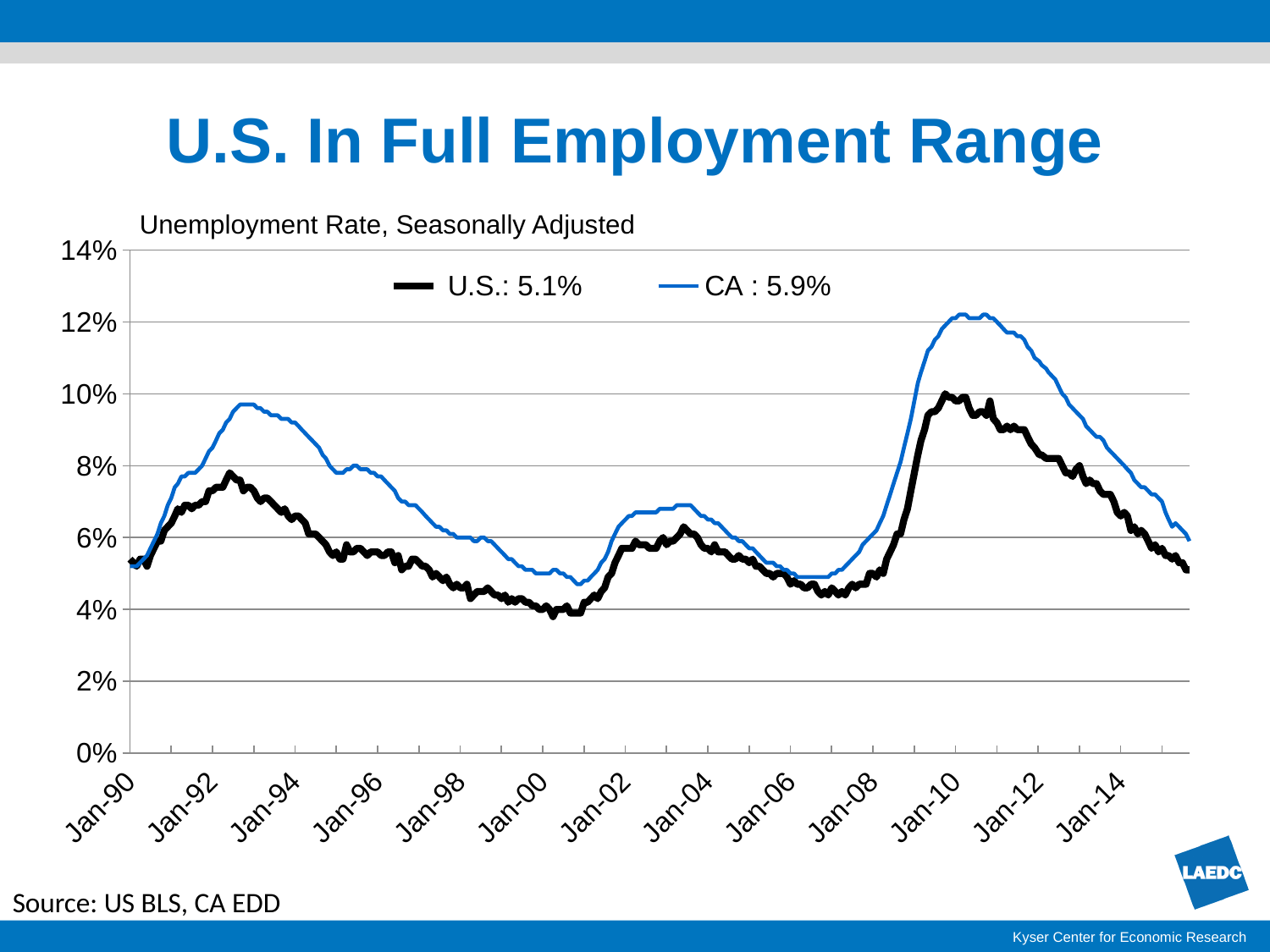
What is the subtitle printed above the chart? Unemployment Rate, Seasonally Adjusted Is the CA value at its peak around Jan-10 greater or less than 10%? greater What kind of chart is shown on the slide? line chart How many year labels are shown on the x axis? 13 According to the legend, what is the latest CA unemployment rate? 5.9% Does the U.S. line rise or fall between Jan-10 and Jan-14? fall Is the U.S. value at its peak around Jan-10 greater or less than 12%? less Which series has the higher latest value, U.S. or CA? CA Which series reaches the higher peak around Jan-10? CA How many series does the legend list? 2 What is the difference between the latest CA rate and the latest U.S. rate shown in the legend? 0.8 percentage points According to the legend, what is the latest U.S. unemployment rate? 5.1%